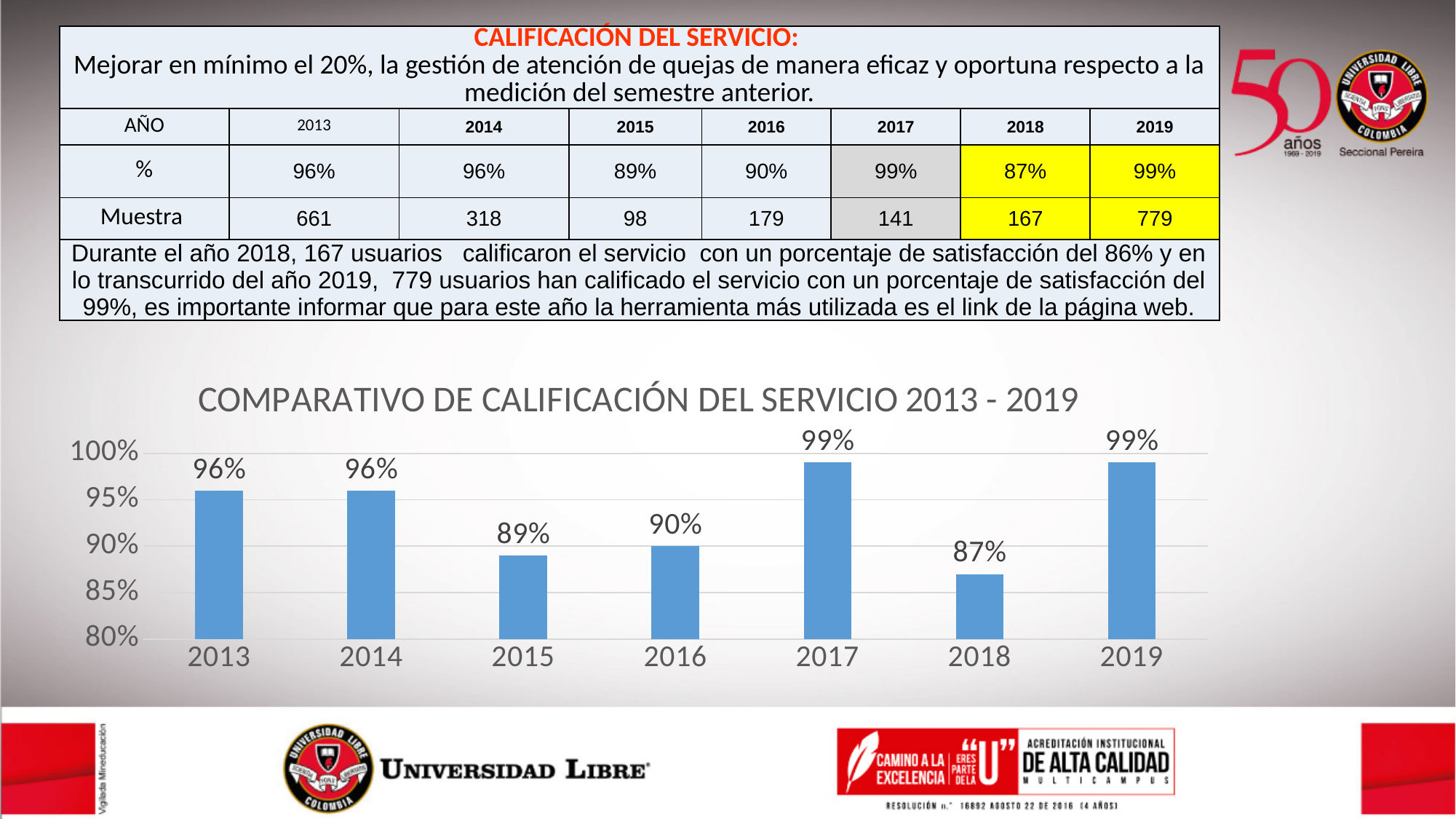
What is the title of the chart? COMPARATIVO DE CALIFICACIÓN DEL SERVICIO 2013 - 2019 Which year has the lowest value in the chart? 2018 What is the value for 2015 in the chart? 89% What is the value for 2018 in the chart? 87% What is the difference between the values for 2019 and 2018? 12% Does the value rise or fall from 2017 to 2018? fall Which is larger, the value for 2016 or the value for 2018? 2016 Is the value for 2014 greater or less than 90%? greater What is the value for 2016 in the chart? 90% What is the difference between the values for 2013 and 2015? 7% How many years are shown on the x axis of the chart? 7 What kind of chart is shown on the slide? bar chart